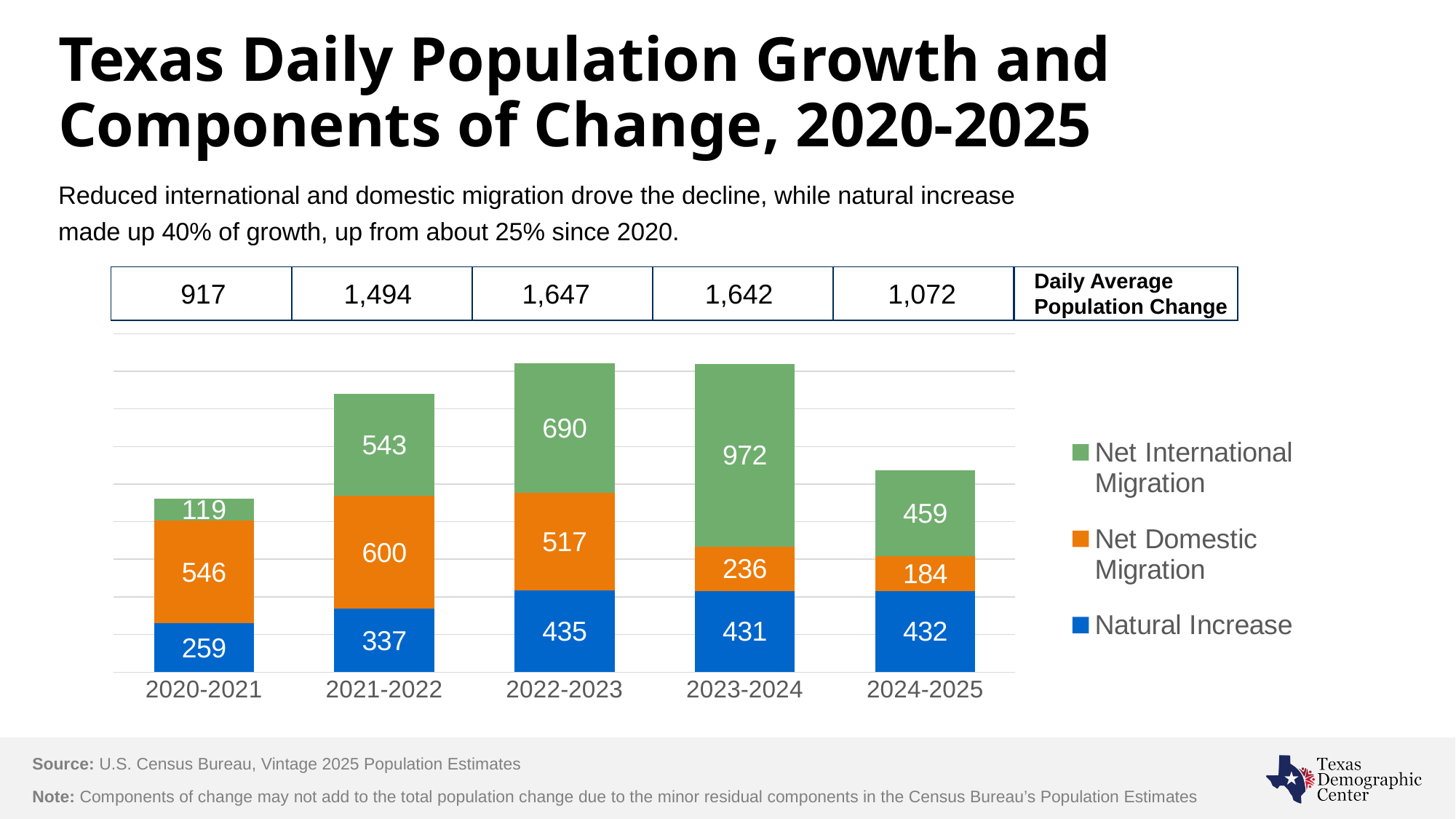
What is the Net Domestic Migration value for 2021-2022? 600 What is the Natural Increase value for 2020-2021? 259 What kind of chart is shown on the slide? Stacked bar chart How many series does the chart legend list? 3 Which period has the lowest Net Domestic Migration value? 2024-2025 Which period has the highest Net International Migration value? 2023-2024 Which colour represents Natural Increase in the chart? Blue What is the difference between the Net Domestic Migration values for 2020-2021 and 2024-2025? 362 How many periods are shown on the x axis of the chart? 5 Which is larger, the Net International Migration value for 2021-2022 or for 2024-2025? 2021-2022 What is the Daily Average Population Change shown for 2022-2023? 1,647 What is the Net International Migration value for 2023-2024? 972